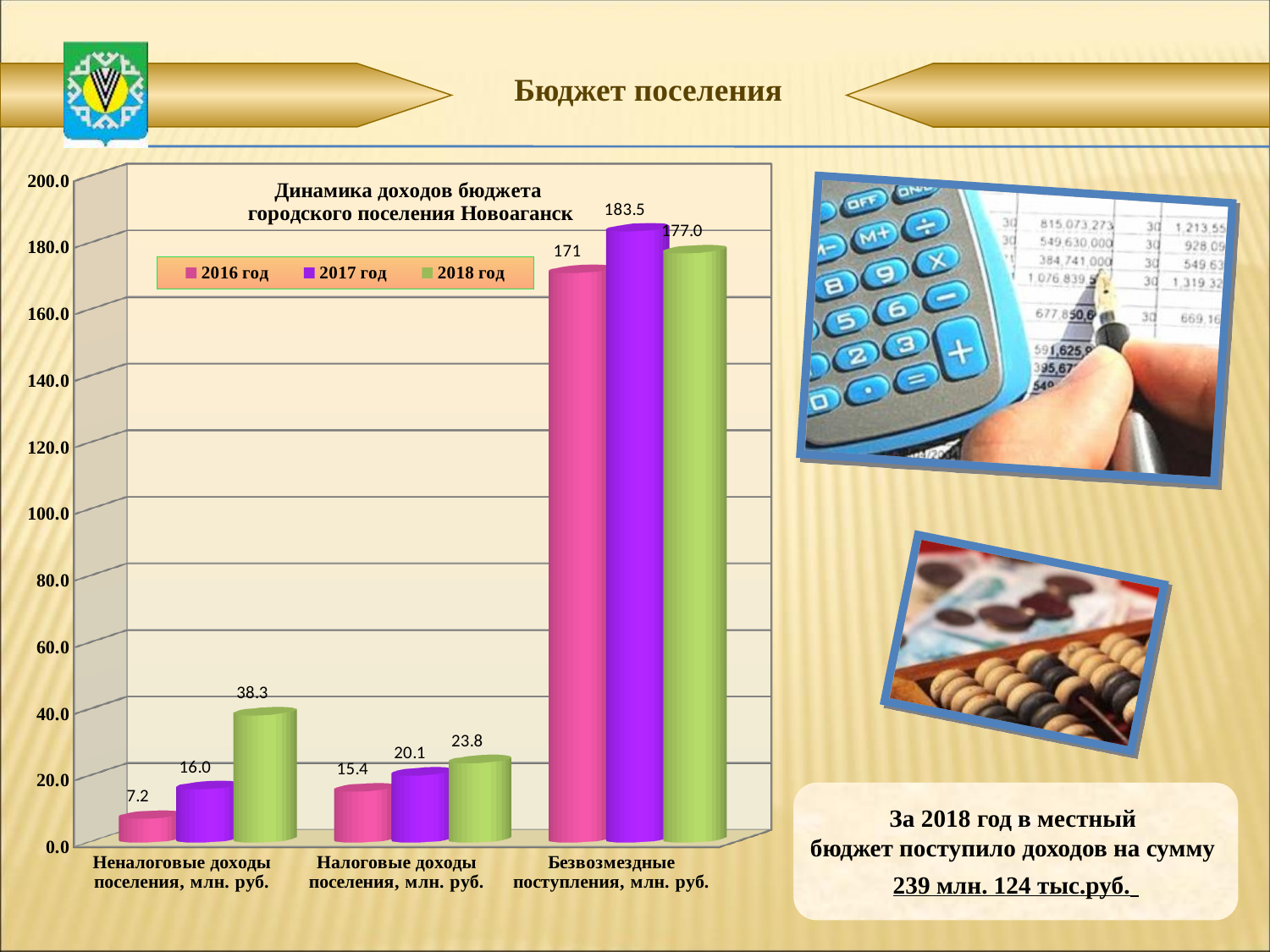
What is the value for 2018 год in the Неналоговые доходы поселения category? 38.3 Which year has the lowest value in the Неналоговые доходы поселения category? 2016 год What is the value for 2016 год in the Налоговые доходы поселения category? 15.4 How many series does the chart legend list? 3 Which is larger: the 2018 год value for Налоговые доходы поселения or the 2018 год value for Неналоговые доходы поселения? Неналоговые доходы поселения Do the values for Налоговые доходы поселения rise or fall from 2016 год to 2018 год? Rise What kind of chart is shown on the slide? Bar chart What is the difference between the 2018 год and 2016 год values for Неналоговые доходы поселения? 31.1 What is the value for 2017 год in the Безвозмездные поступления category? 183.5 Which year has the highest value in the Безвозмездные поступления category? 2017 год How many categories are shown on the x axis of the chart? 3 Is the 2016 год value for Безвозмездные поступления greater or less than 160.0? greater